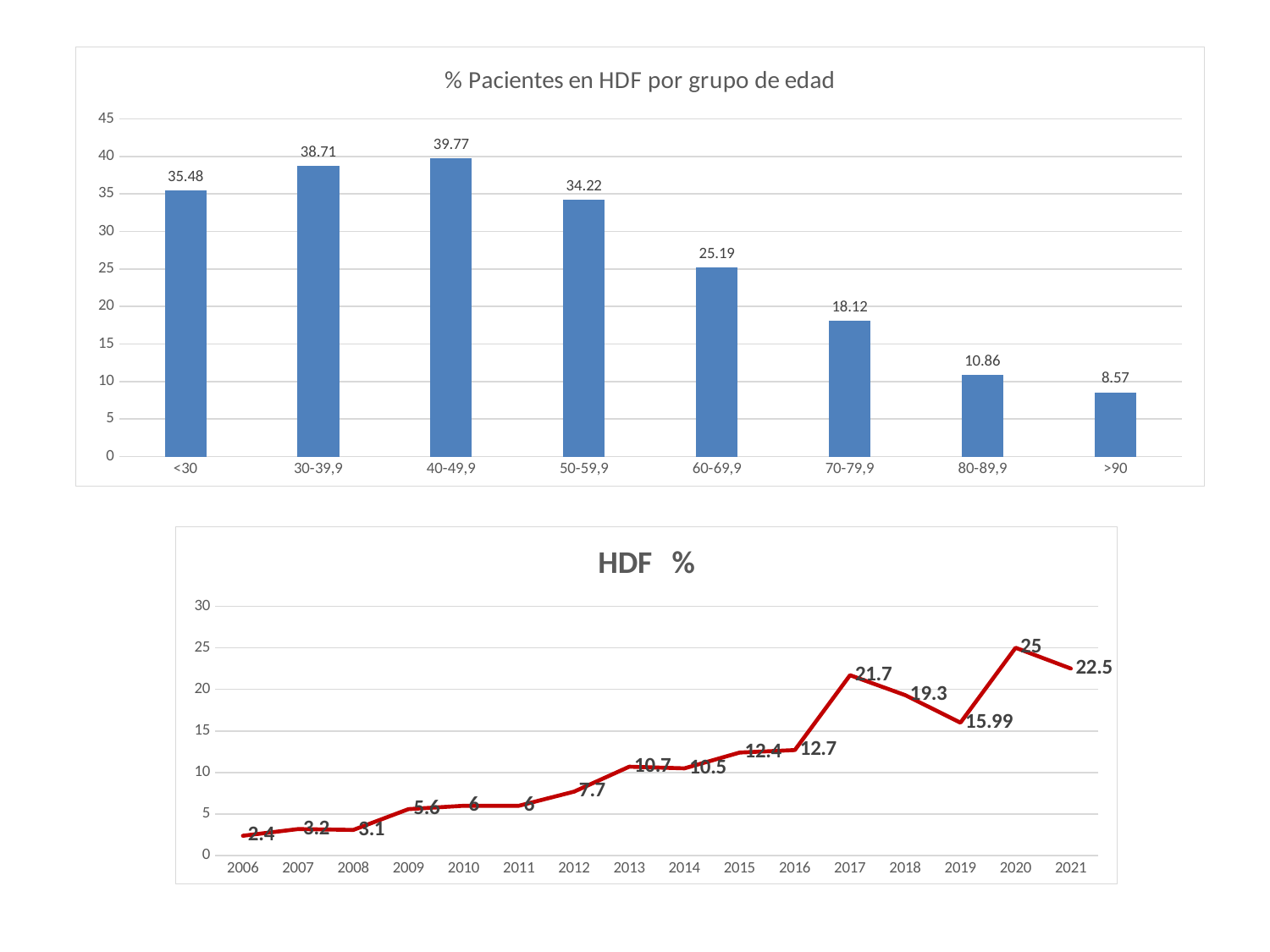
In the chart titled '% Pacientes en HDF por grupo de edad', what is the difference between the values for 60-69,9 and 70-79,9? 7.07 In the chart titled '% Pacientes en HDF por grupo de edad', what is the value for the 40-49,9 age group? 39.77 In the chart titled 'HDF %', how many years are plotted on the x axis? 16 In the chart titled '% Pacientes en HDF por grupo de edad', how many age groups are shown? 8 In the chart titled 'HDF %', is the value for 2017 larger than the value for 2018? Yes In the chart titled 'HDF %', which year has the highest value? 2020 In the chart titled 'HDF %', what is the value for 2019? 15.99 In the chart titled '% Pacientes en HDF por grupo de edad', which age group has the lowest value? >90 What type of chart is the top chart titled '% Pacientes en HDF por grupo de edad'? Bar chart In the chart titled 'HDF %', what is the difference between the values for 2020 and 2021? 2.5 In the chart titled 'HDF %', which year has the lowest value? 2006 In the chart titled '% Pacientes en HDF por grupo de edad', which age group has the highest value? 40-49,9